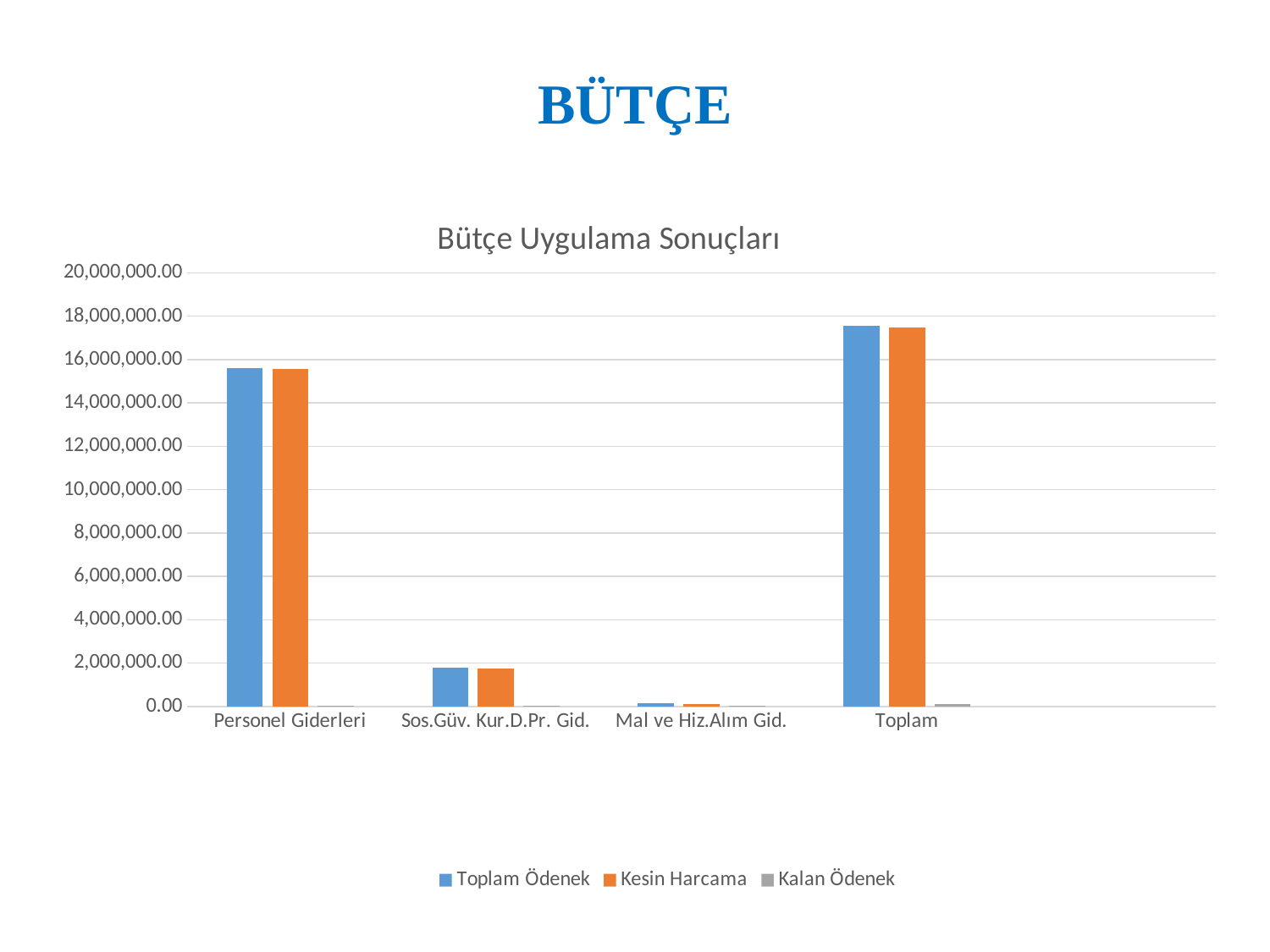
Which is larger, the Toplam Ödenek value for Personel Giderleri or for Sos.Güv. Kur.D.Pr. Gid.? Personel Giderleri Which category has the highest Toplam Ödenek value? Toplam Which series is shown in orange in the legend? Kesin Harcama How many categories are shown on the x axis? 4 What is the title of the chart? Bütçe Uygulama Sonuçları How many series does the legend list? 3 Is the Toplam Ödenek value for Sos.Güv. Kur.D.Pr. Gid. greater or less than 2,000,000.00? less What kind of chart is shown on the slide? bar chart Which category has the lowest Kesin Harcama value? Mal ve Hiz.Alım Gid. Is the Toplam Ödenek value for Personel Giderleri greater or less than 14,000,000.00? greater Is the Kesin Harcama value for Toplam greater or less than 16,000,000.00? greater